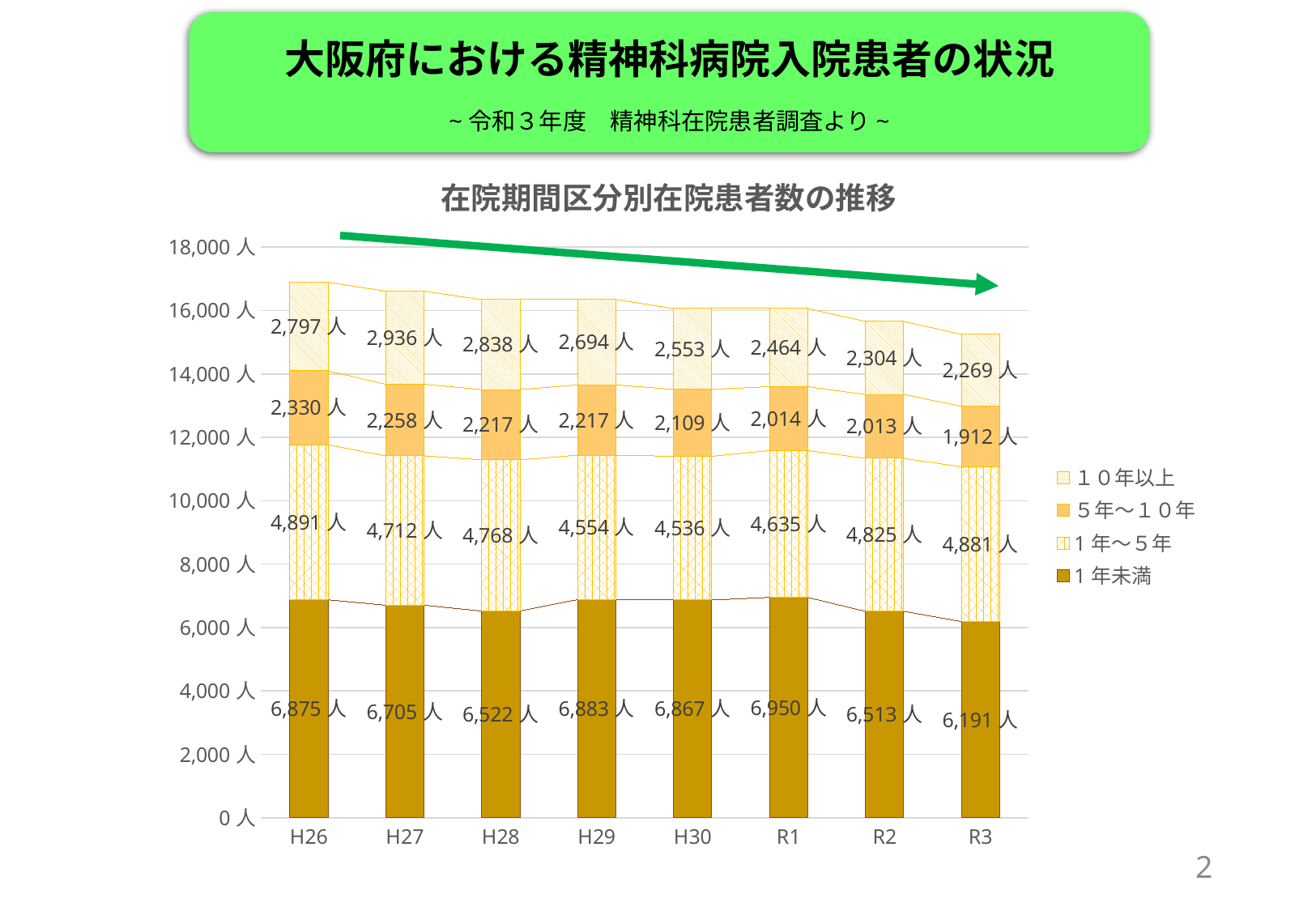
In which year is the 10年以上 value the highest? H27 What is the difference between the 1年未満 values for H26 and R3? 684 人 What is the value for 5年～10年 in R3? 1,912 人 Which is larger, the 1年～5年 value for H26 or for H27? H26 How many series does the legend list? 4 What is the title of the chart? 在院期間区分別在院患者数の推移 How many years (categories) are shown on the x axis? 8 What kind of chart is shown on the slide? Stacked bar chart What is the total of the stacked bar for R3? 15,253 人 What is the value for 10年以上 in H27? 2,936 人 In which year is the 1年未満 value the lowest? R3 What is the value for 1年未満 in R1? 6,950 人